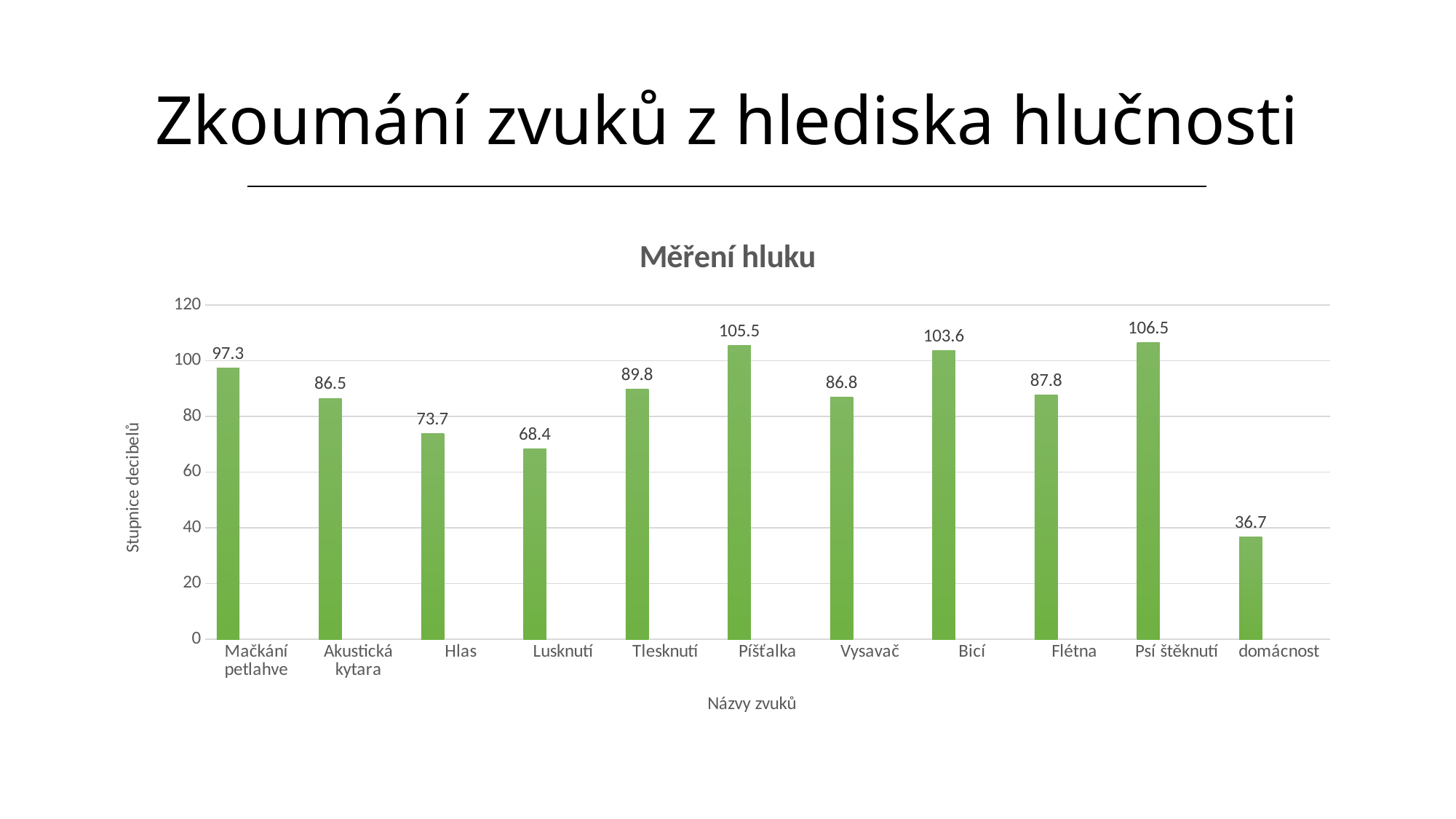
What is the value for Píšťalka? 105.5 What is the title of the chart? Měření hluku What is the value for Mačkání petlahve? 97.3 Which category has the highest value? Psí štěknutí How many categories are shown on the x axis? 11 What is the difference between the values for Psí štěknutí and Píšťalka? 1.0 What is the value for domácnost? 36.7 What kind of chart is shown? bar chart Is the value for Vysavač greater or less than 80? greater Which category has the lowest value? domácnost Which is larger, the value for Tlesknutí or the value for Lusknutí? Tlesknutí What is the difference between the values for Bicí and Hlas? 29.9